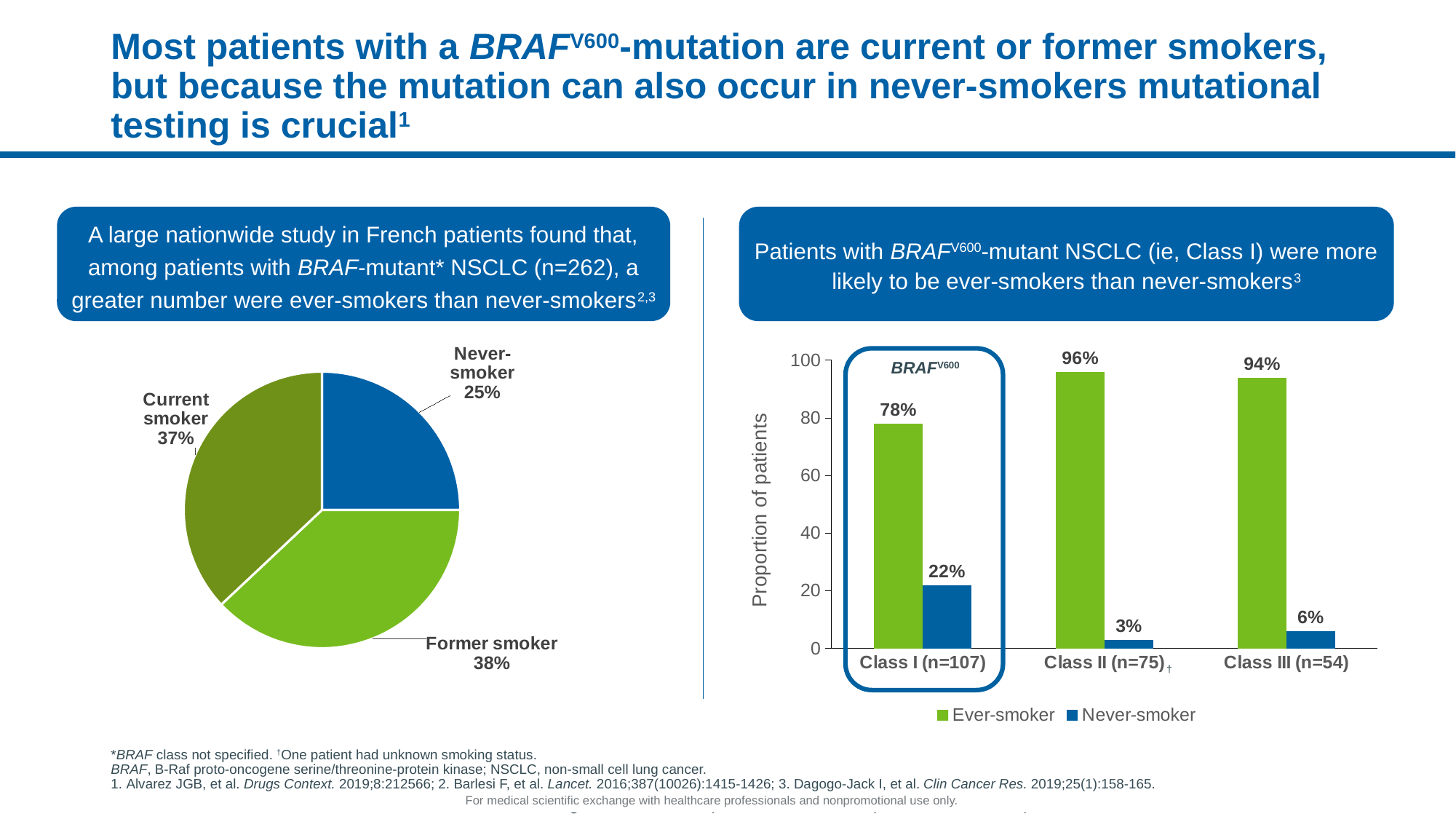
In the bar chart on the right, what is the proportion of ever-smokers in Class I (n=107)? 78% In the bar chart on the right, how many series does the legend list? 2 In the pie chart on the left, how many slices are there? 3 In the pie chart on the left, what share of patients were former smokers? 38% In the bar chart on the right, which class has the highest proportion of ever-smokers? Class II (n=75) In the pie chart on the left, what is the difference between the current smoker and never-smoker shares? 12% In the pie chart on the left, which category has the smallest share? Never-smoker What type of chart is shown on the right side of the slide? Bar chart In the bar chart on the right, what is the proportion of never-smokers in Class II (n=75)? 3% In the pie chart on the left, which category has the largest share? Former smoker In the pie chart on the left, what share of patients were never-smokers? 25% In the bar chart on the right, what is the difference between the ever-smoker and never-smoker proportions in Class III (n=54)? 88%